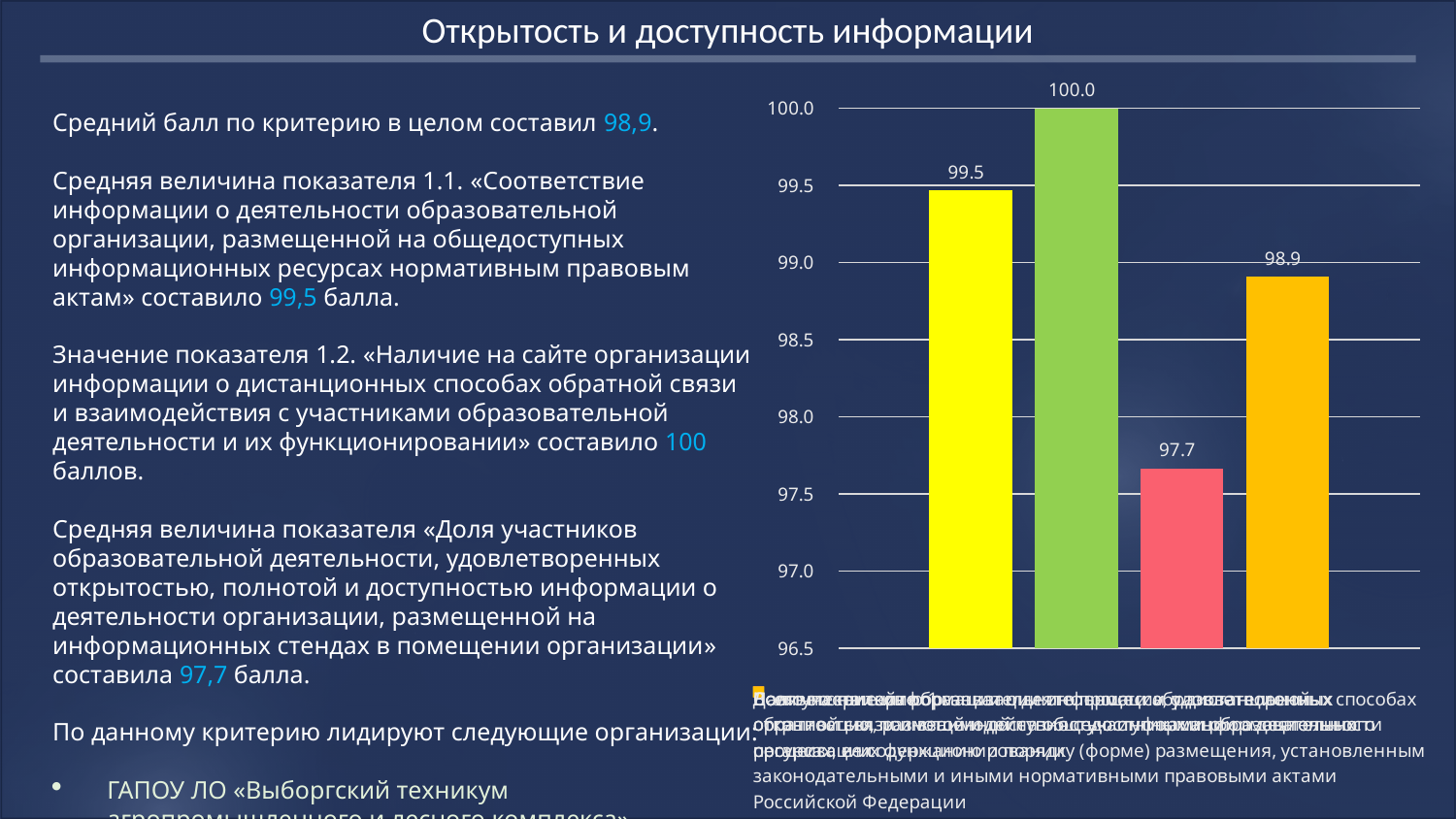
Which is larger, the value of the yellow bar or the value of the orange bar? The yellow bar Which bar has the lowest value in the chart? The red bar (97.7) Is the value of the red bar greater or less than 98.0? less What is the value shown on the green bar in the chart? 100.0 Which bar has the highest value in the chart? The green bar (100.0) What type of chart is shown on the slide? Bar chart What is the value shown on the yellow bar in the chart? 99.5 What is the difference between the yellow bar and the orange bar values? 0.6 What is the value shown on the orange bar in the chart? 98.9 What is the value shown on the red bar in the chart? 97.7 How many bars are plotted in the chart? 4 What is the difference between the green bar and the red bar values? 2.3